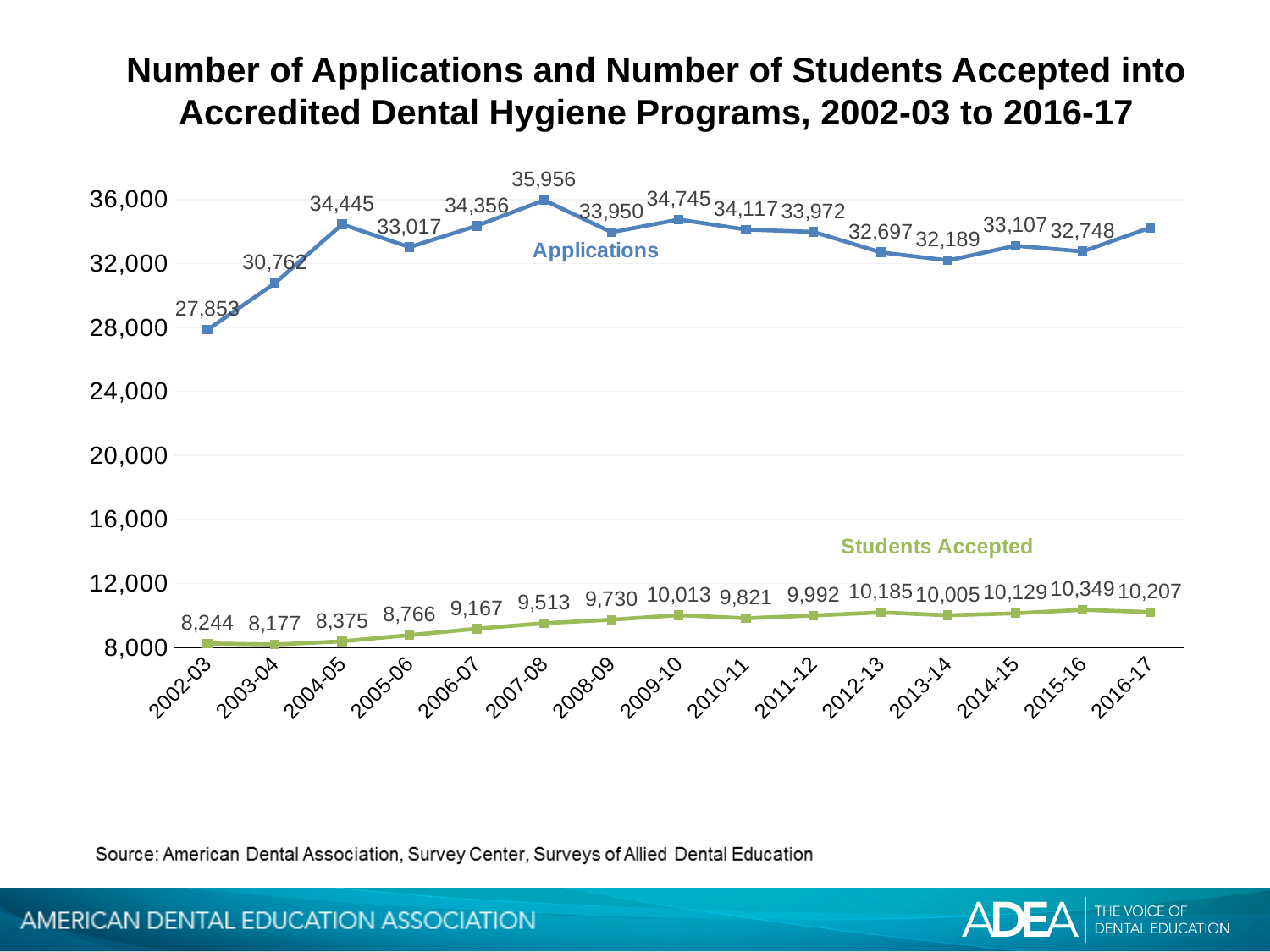
By how much did the number of applications increase from 2002-03 to 2003-04? 2,909 In which academic year was the number of students accepted lowest? 2003-04 What kind of chart is shown on the slide? line chart What was the number of applications in 2002-03? 27,853 How many academic years are shown on the x axis? 15 How many data series are plotted on the chart? 2 How many students were accepted in 2015-16? 10,349 Which was larger, the number of students accepted in 2009-10 or in 2010-11? 2009-10 In which academic year was the number of applications highest? 2007-08 Is the number of applications in 2016-17 greater or less than 32,000? greater What was the number of applications in 2007-08? 35,956 What is the difference between the number of applications and the number of students accepted in 2007-08? 26,443